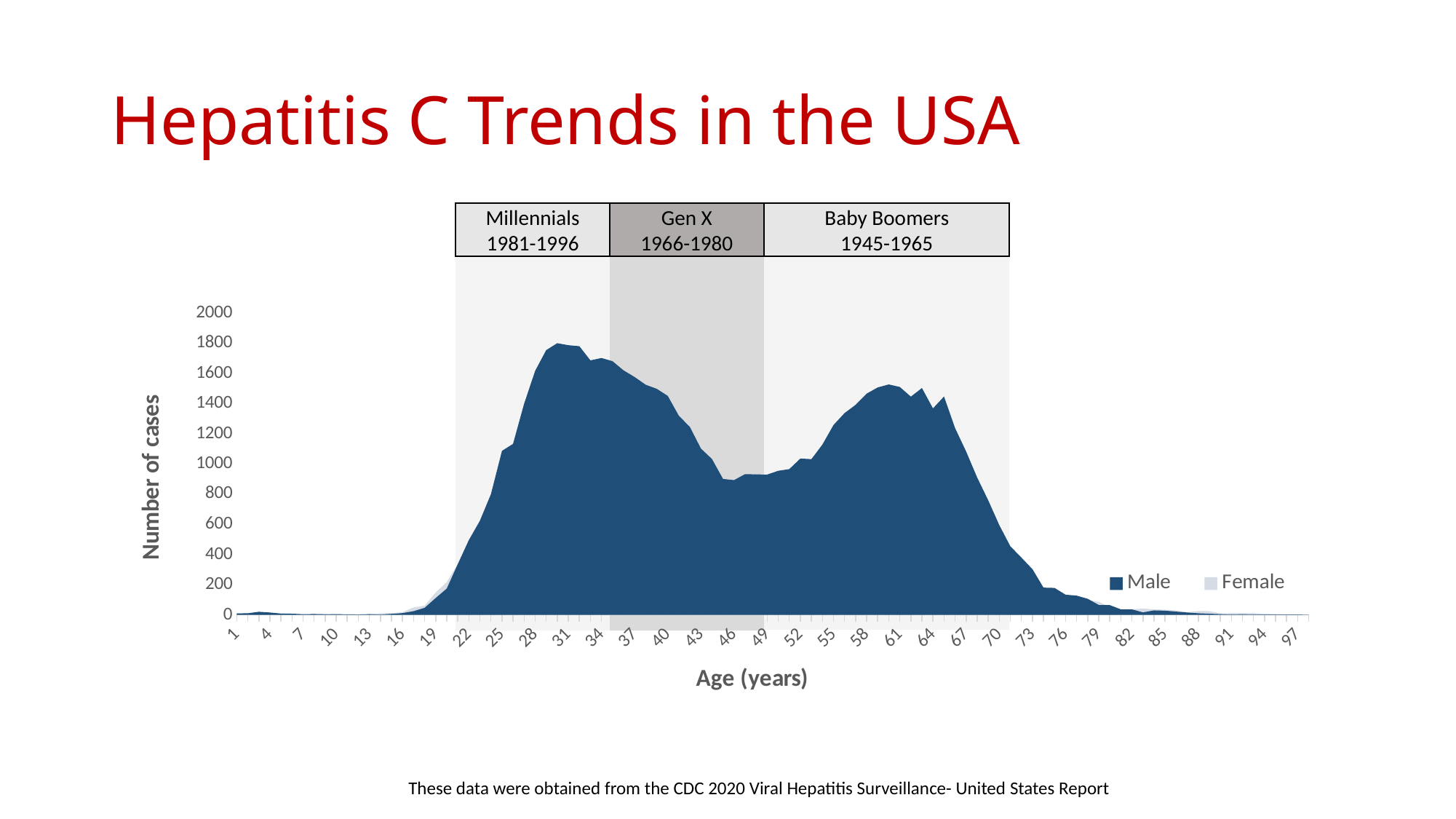
What is the title of the chart's vertical axis? Number of cases Which is larger for Male: the value at age 31 or the value at age 61? Age 31 Is the Male value at age 73 greater or less than 600? less Is the Male value at age 46 greater or less than 1000? less Is the Male value at age 61 greater or less than 1200? greater What kind of chart is shown on the slide? Area chart How many series does the chart legend list? 2 What are the two series named in the chart legend? Male and Female Do the Male values rise or fall between age 64 and age 73? Fall Do the Male values rise or fall between age 19 and age 28? Rise